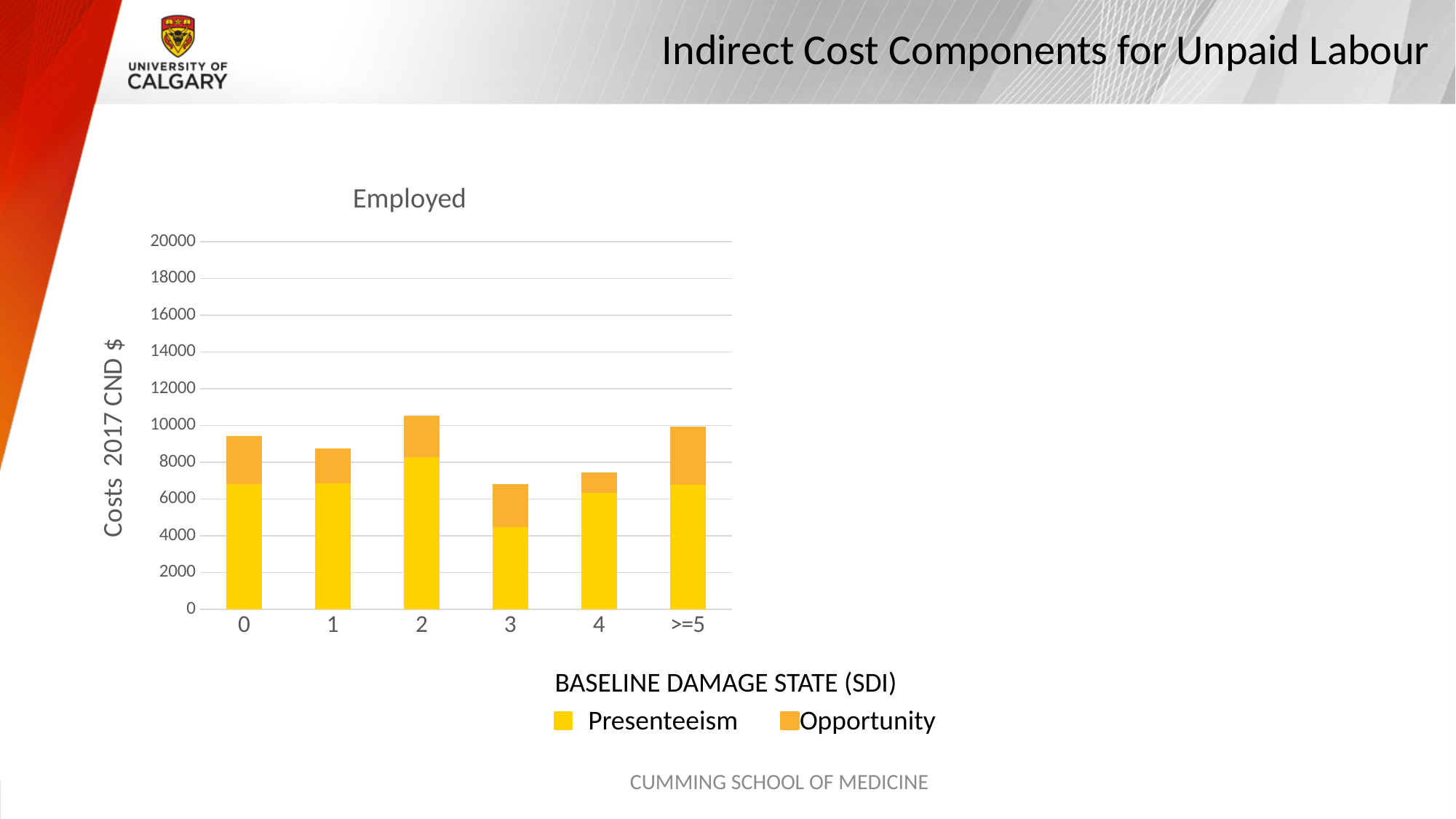
Which baseline damage state has the lowest Presenteeism cost? 3 Which baseline damage state has the lowest total cost? 3 Which baseline damage state has the highest total cost? 2 Is the total cost for baseline damage state 2 greater or less than 10000? greater How many series does the legend list? 2 Is the total cost for baseline damage state 3 greater or less than 8000? less Is the Presenteeism cost for baseline damage state 3 greater or less than 6000? less What is the title of the chart? Employed Which has the larger total cost, baseline damage state 0 or baseline damage state 1? 0 What kind of chart is shown on the slide? Stacked bar chart Which baseline damage state has the highest Presenteeism cost? 2 How many baseline damage state categories are shown on the x axis? 6